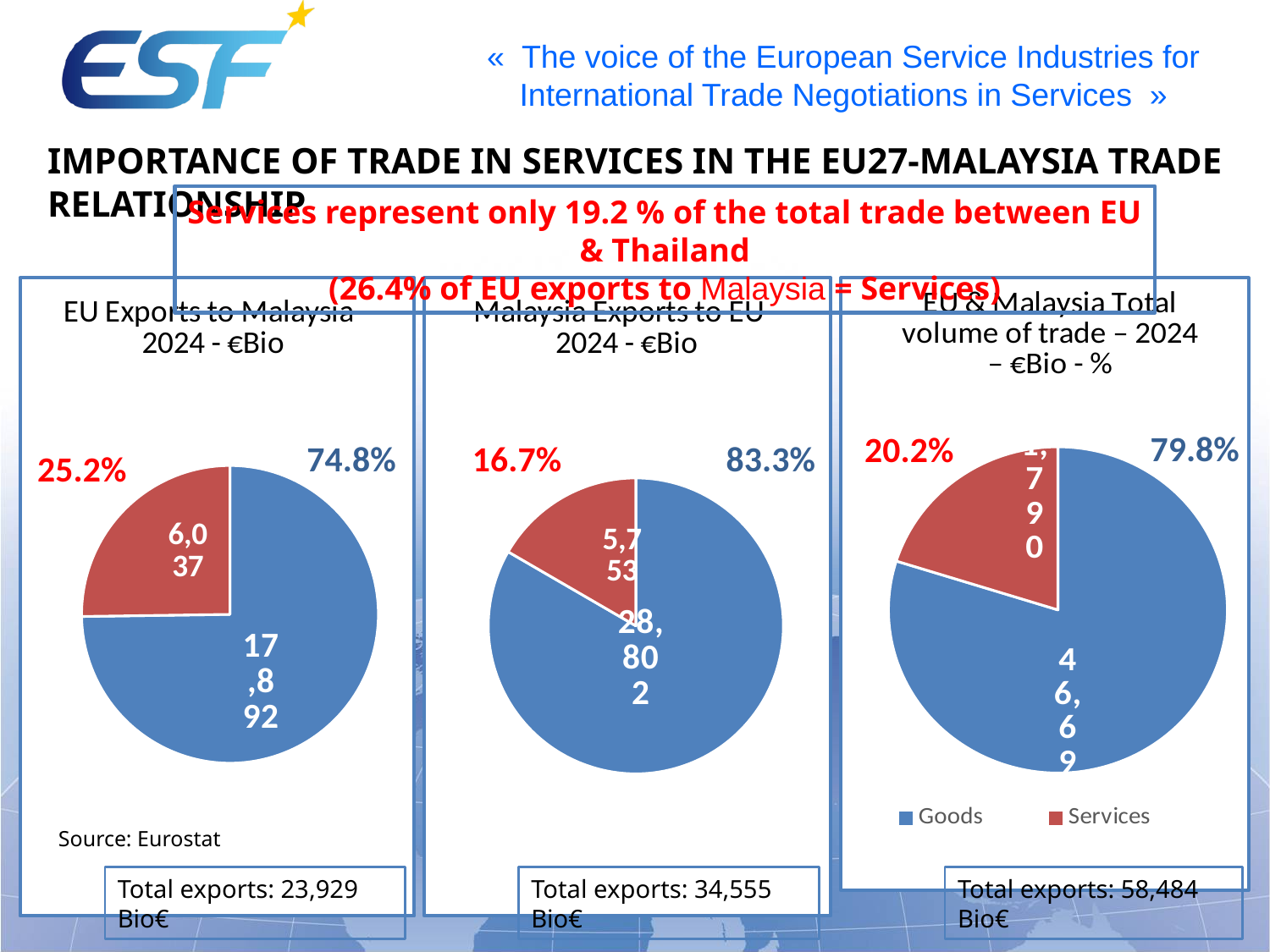
In the 'Malaysia Exports to EU 2024 - €Bio' chart, what share of the pie is Services? 16.7% In the 'Malaysia Exports to EU 2024 - €Bio' chart, what share of the pie is Goods? 83.3% In the 'EU Exports to Malaysia 2024 - €Bio' chart, what value is shown on the Services slice? 6,037 In the 'EU & Malaysia Total volume of trade – 2024' chart, which slice is larger, Goods or Services? Goods In the 'EU Exports to Malaysia 2024 - €Bio' chart, what share of the pie is Goods? 74.8% In the 'Malaysia Exports to EU 2024 - €Bio' chart, what value is shown on the Services slice? 5,753 What type of chart is used in the 'EU Exports to Malaysia 2024 - €Bio' chart? Pie chart How many slices does the 'Malaysia Exports to EU 2024 - €Bio' pie chart have? 2 In the 'EU Exports to Malaysia 2024 - €Bio' chart, what value is shown on the Goods slice? 17,892 What two entries does the legend of the 'EU & Malaysia Total volume of trade – 2024' chart list? Goods and Services